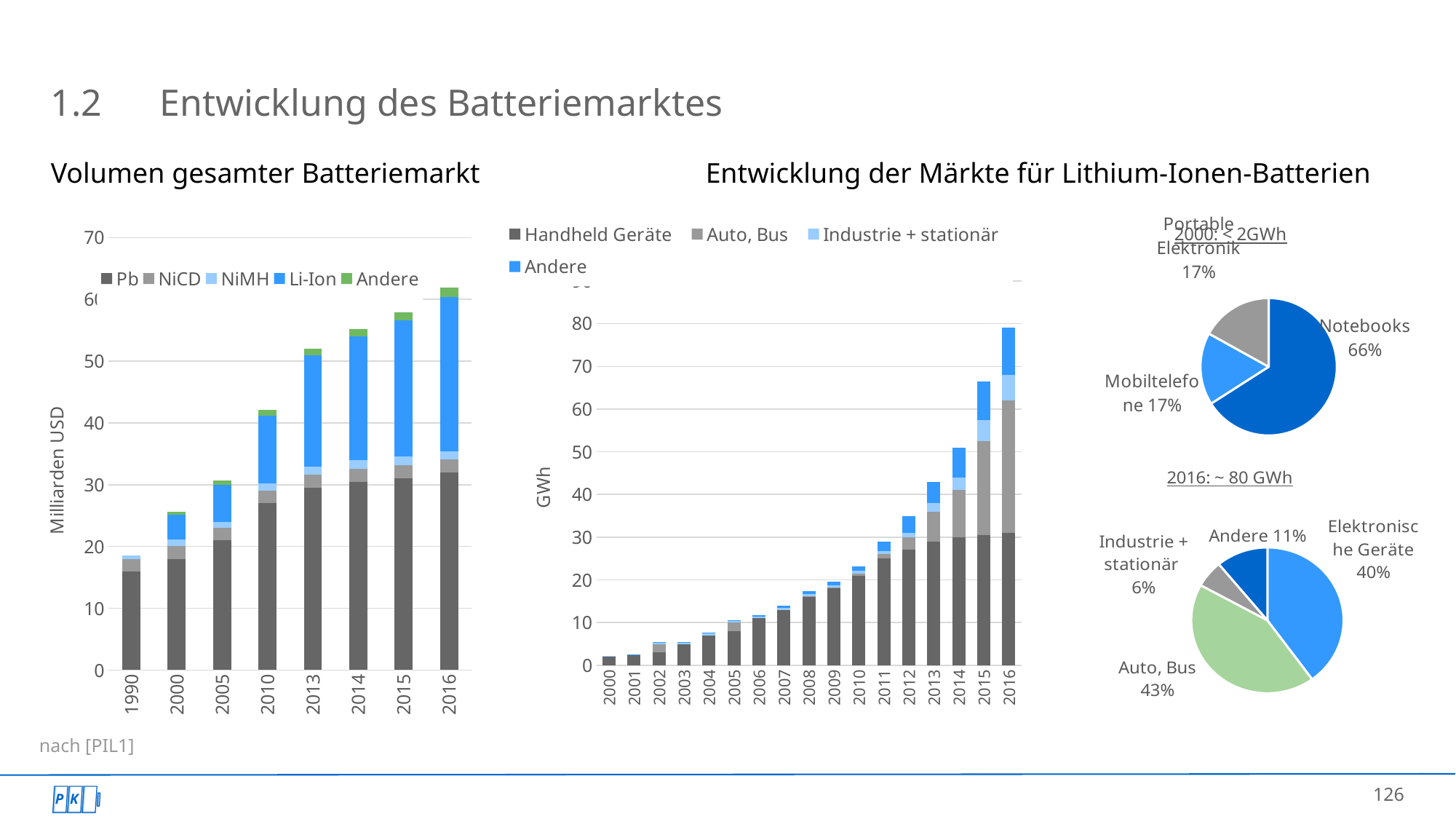
In the chart titled 'Volumen gesamter Batteriemarkt', what kind of chart is it? stacked bar chart In the chart titled 'Volumen gesamter Batteriemarkt', how many years are shown on the x axis? 8 In the pie chart titled '2000: < 2GWh', what share do Notebooks have? 66% In the middle bar chart (GWh), do the total values rise or fall from 2000 to 2016? rise In the chart titled 'Volumen gesamter Batteriemarkt', is the total for 2010 greater or less than 40? greater In the pie chart titled '2016: ~ 80 GWh', which slice is the largest? Auto, Bus In the chart titled 'Volumen gesamter Batteriemarkt', how many series does the legend list? 5 In the middle bar chart (GWh), how many years are shown on the x axis? 17 In the middle bar chart (GWh), which year has the lowest total bar? 2000 In the chart titled 'Volumen gesamter Batteriemarkt', which year has the highest total bar? 2016 In the middle bar chart (GWh), how many series does the legend list? 4 In the middle bar chart (GWh), is the total for 2015 greater or less than 60? greater